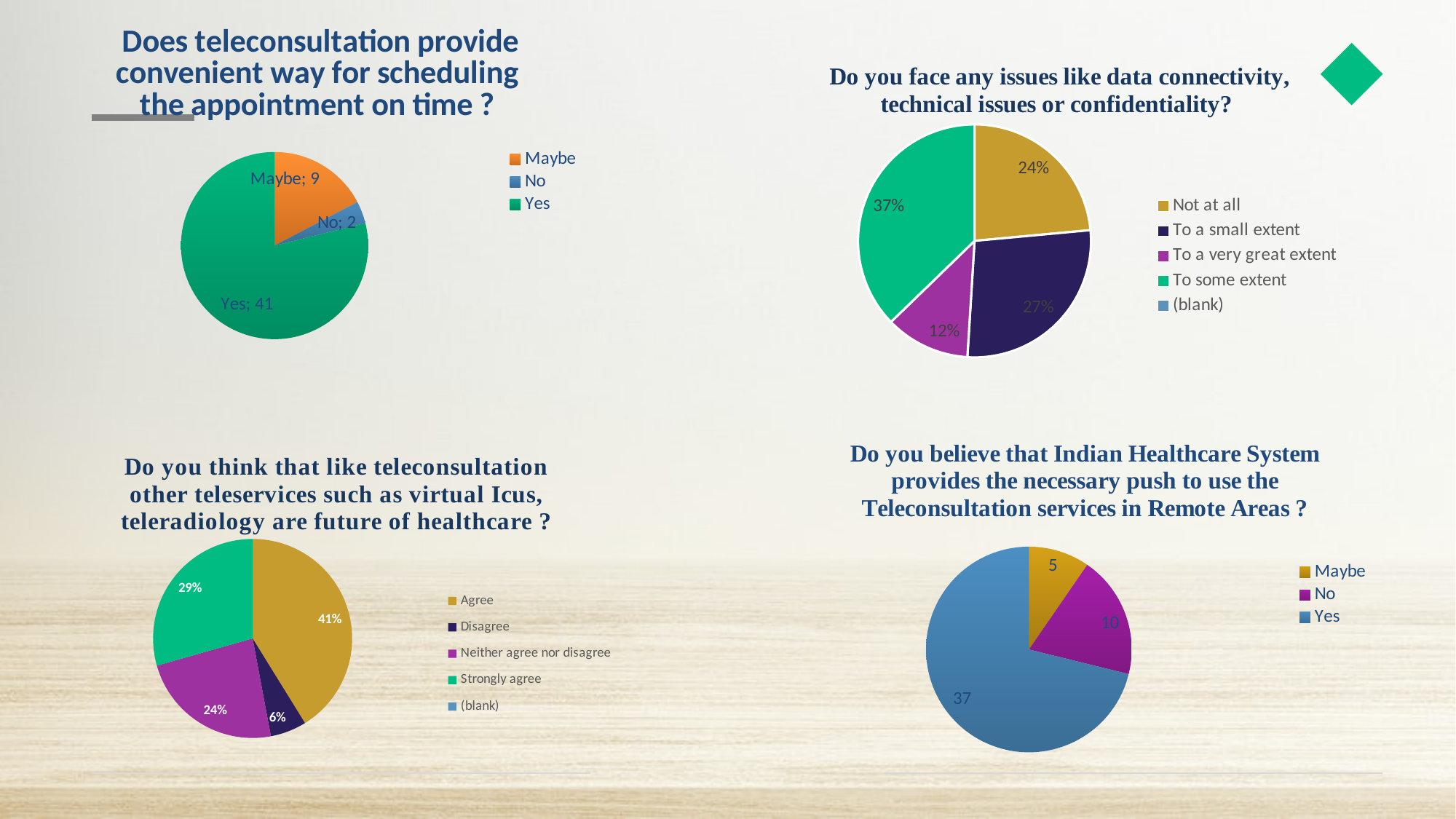
In the bottom-left chart about teleservices being the future of healthcare, what is the difference between Agree and Disagree? 35% In the top-right chart about data connectivity issues, which response has the smallest share? To a very great extent In the top-left chart about scheduling appointments on time, what is the difference between the Yes and Maybe counts? 32 In the top-left chart about scheduling appointments on time, how many respondents answered No? 2 In the top-left chart about scheduling appointments on time, how many respondents answered Yes? 41 What kind of chart is used for the question about facing issues like data connectivity, technical issues or confidentiality? Pie chart In the bottom-left chart about teleservices being the future of healthcare, what percentage chose Agree? 41% In the bottom-right chart about the Indian Healthcare System providing a push for teleconsultation in remote areas, how many respondents answered Yes? 37 In the top-right chart about data connectivity issues, what percentage answered 'To some extent'? 37% How many entries does the legend list for the top-right chart about data connectivity issues? 5 In the bottom-left chart about teleservices being the future of healthcare, which is larger: Strongly agree or Neither agree nor disagree? Strongly agree In the bottom-right chart about the Indian Healthcare System providing a push for teleconsultation in remote areas, what is the total of all three responses? 52